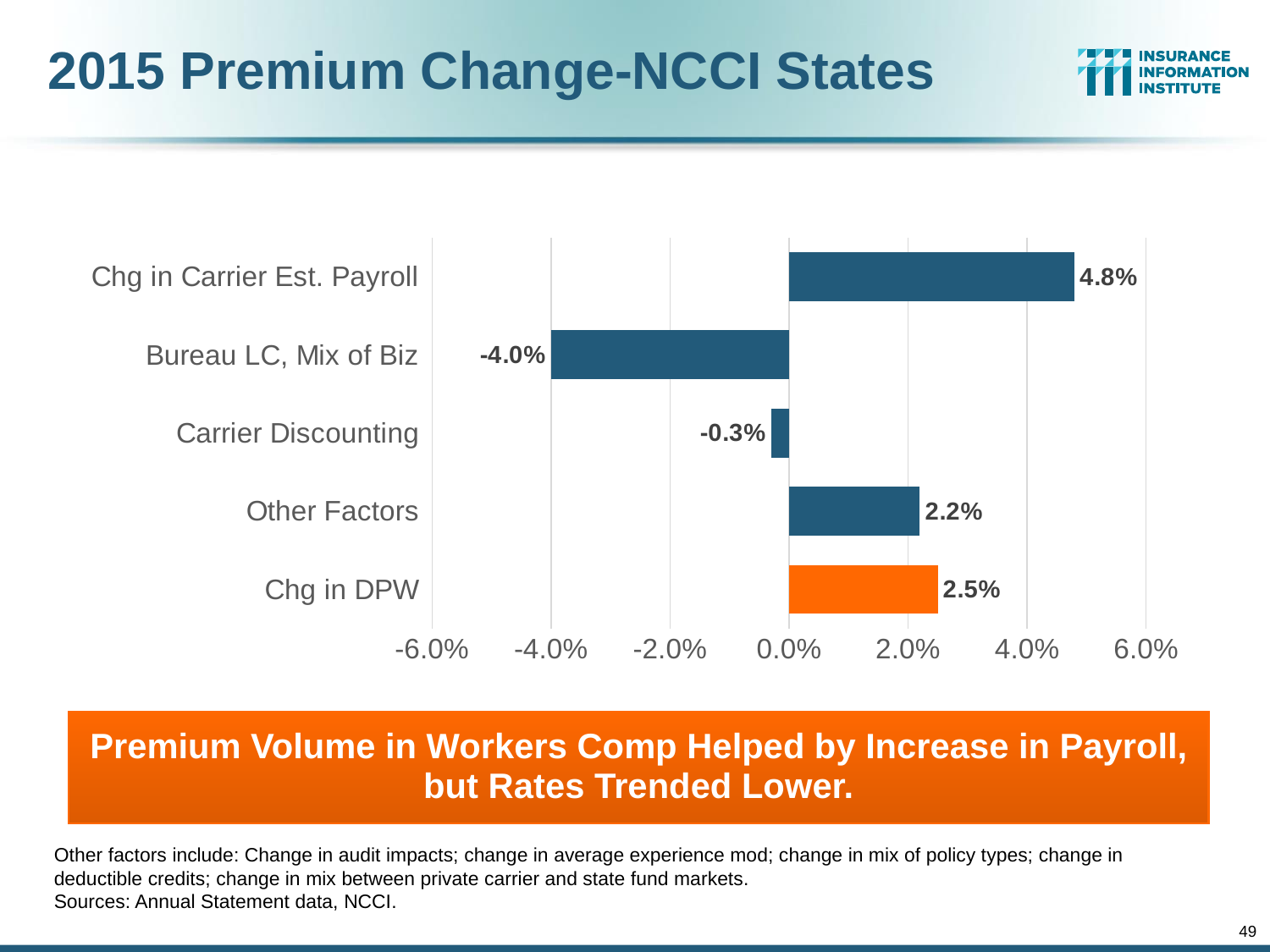
What is the value for Bureau LC, Mix of Biz? -4.0% Which is larger, the value for Other Factors or the value for Chg in DPW? Chg in DPW Which category has the lowest value? Bureau LC, Mix of Biz What is the value for Chg in Carrier Est. Payroll? 4.8% What is the difference between the values for Chg in Carrier Est. Payroll and Chg in DPW? 2.3% What is the value for Carrier Discounting? -0.3% Which category's bar is coloured orange rather than blue? Chg in DPW Is the value for Chg in Carrier Est. Payroll greater or less than 4.0%? greater What kind of chart is shown on the slide? Bar chart Which category has the highest value? Chg in Carrier Est. Payroll How many categories are shown in the chart? 5 What is the value for Chg in DPW? 2.5%